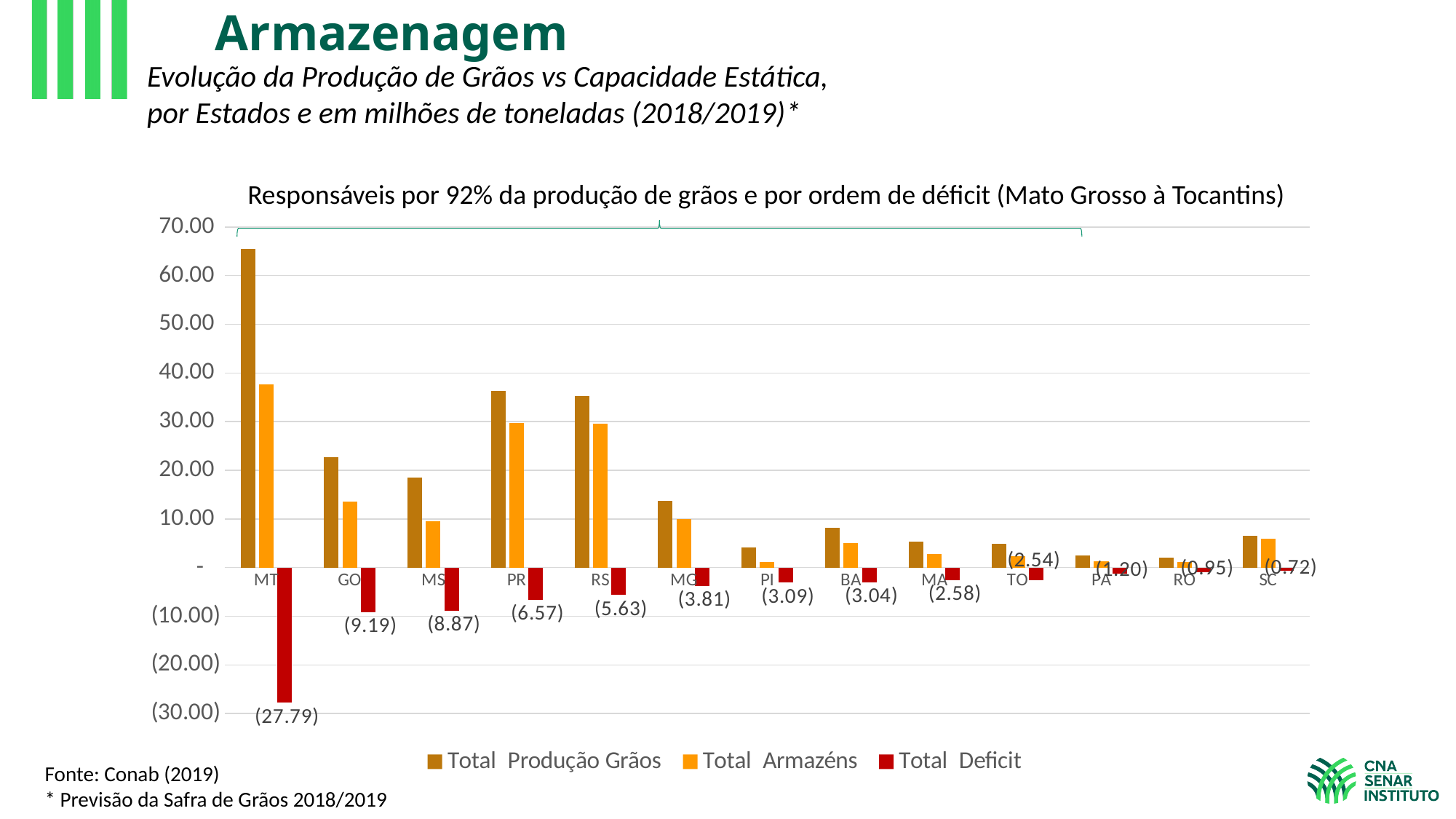
What is the Total Deficit value shown for SC? (0.72) How many states are shown on the x axis of the chart? 13 Which state has the largest Total Deficit? MT Which state has the highest Total Produção Grãos bar? MT What is the difference between the Total Deficit of GO and MS? 0.32 Is the Total Produção Grãos value for MT greater or less than 60.00? greater What is the Total Deficit value shown for GO? (9.19) Which state has a larger Total Produção Grãos bar, GO or MS? GO How many series does the legend list? 3 What kind of chart is shown on the slide? bar chart What is the Total Deficit value shown for MT? (27.79) Which state has the smallest Total Deficit? SC